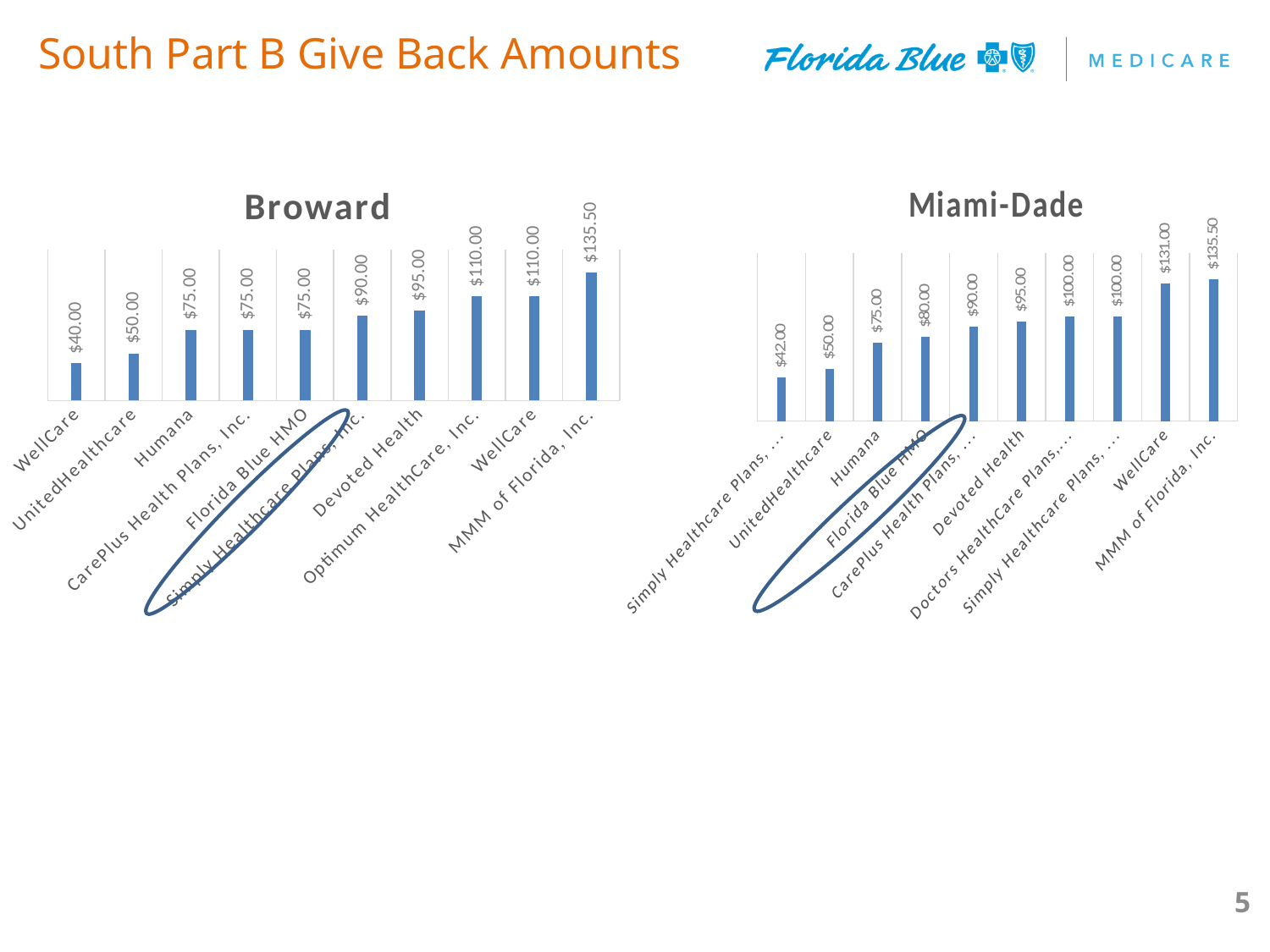
In the Miami-Dade chart, do the values rise or fall from left to right? Rise In the Miami-Dade chart, what is the difference between MMM of Florida, Inc. and WellCare? $4.50 In the Broward chart, what is the difference between MMM of Florida, Inc. and UnitedHealthcare? $85.50 What kind of chart is the Broward chart? Bar chart In the Broward chart, how many bars are plotted? 10 In the Miami-Dade chart, which company has the lowest give back amount? Simply Healthcare Plans In the Miami-Dade chart, which is larger, the value for Devoted Health or the value for Humana? Devoted Health In the Broward chart, what is the give back amount for Humana? $75.00 In the Broward chart, which company has the highest give back amount? MMM of Florida, Inc. In the Broward chart, what is the value for Devoted Health? $95.00 In the Miami-Dade chart, what is the value for WellCare? $131.00 In the Miami-Dade chart, what is the value for Florida Blue HMO? $80.00